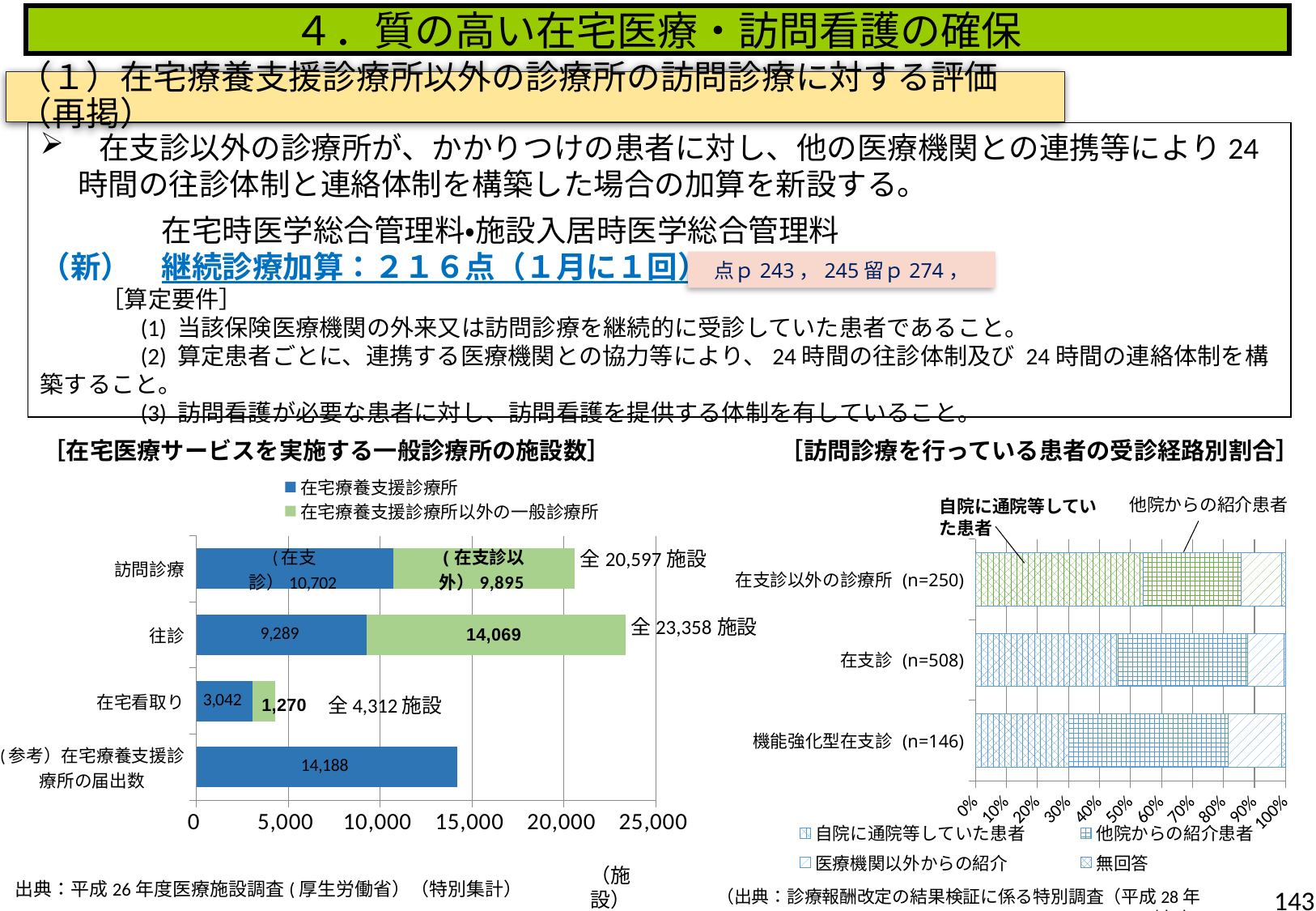
In the left chart [在宅医療サービスを実施する一般診療所の施設数], what is the total number of facilities shown for the 在宅看取り bar? 4,312 In the left chart [在宅医療サービスを実施する一般診療所の施設数], what is the difference between the 在宅療養支援診療所以外の一般診療所 value and the 在宅療養支援診療所 value in the 往診 category? 4,780 In the right chart [訪問診療を行っている患者の受診経路別割合], is the share of 自院に通院等していた患者 for 在支診以外の診療所 (n=250) greater or less than 40%? greater In the left chart [在宅医療サービスを実施する一般診療所の施設数], which is larger in the 在宅看取り category: 在宅療養支援診療所 or 在宅療養支援診療所以外の一般診療所? 在宅療養支援診療所 What kind of chart is the right chart [訪問診療を行っている患者の受診経路別割合]? Stacked bar chart In the left chart [在宅医療サービスを実施する一般診療所の施設数], which category has the largest total number of facilities? 往診 In the left chart [在宅医療サービスを実施する一般診療所の施設数], how many series does the legend list? 2 In the left chart [在宅医療サービスを実施する一般診療所の施設数], what is the value for 在宅療養支援診療所以外の一般診療所 in the 往診 category? 14,069 In the left chart [在宅医療サービスを実施する一般診療所の施設数], what is the total for the 往診 bar? 23,358 In the left chart [在宅医療サービスを実施する一般診療所の施設数], what is the value for 在宅療養支援診療所 in the 訪問診療 category? 10,702 In the left chart [在宅医療サービスを実施する一般診療所の施設数], which category has the smallest total number of facilities? 在宅看取り In the right chart [訪問診療を行っている患者の受診経路別割合], how many categories are shown on the vertical axis? 3